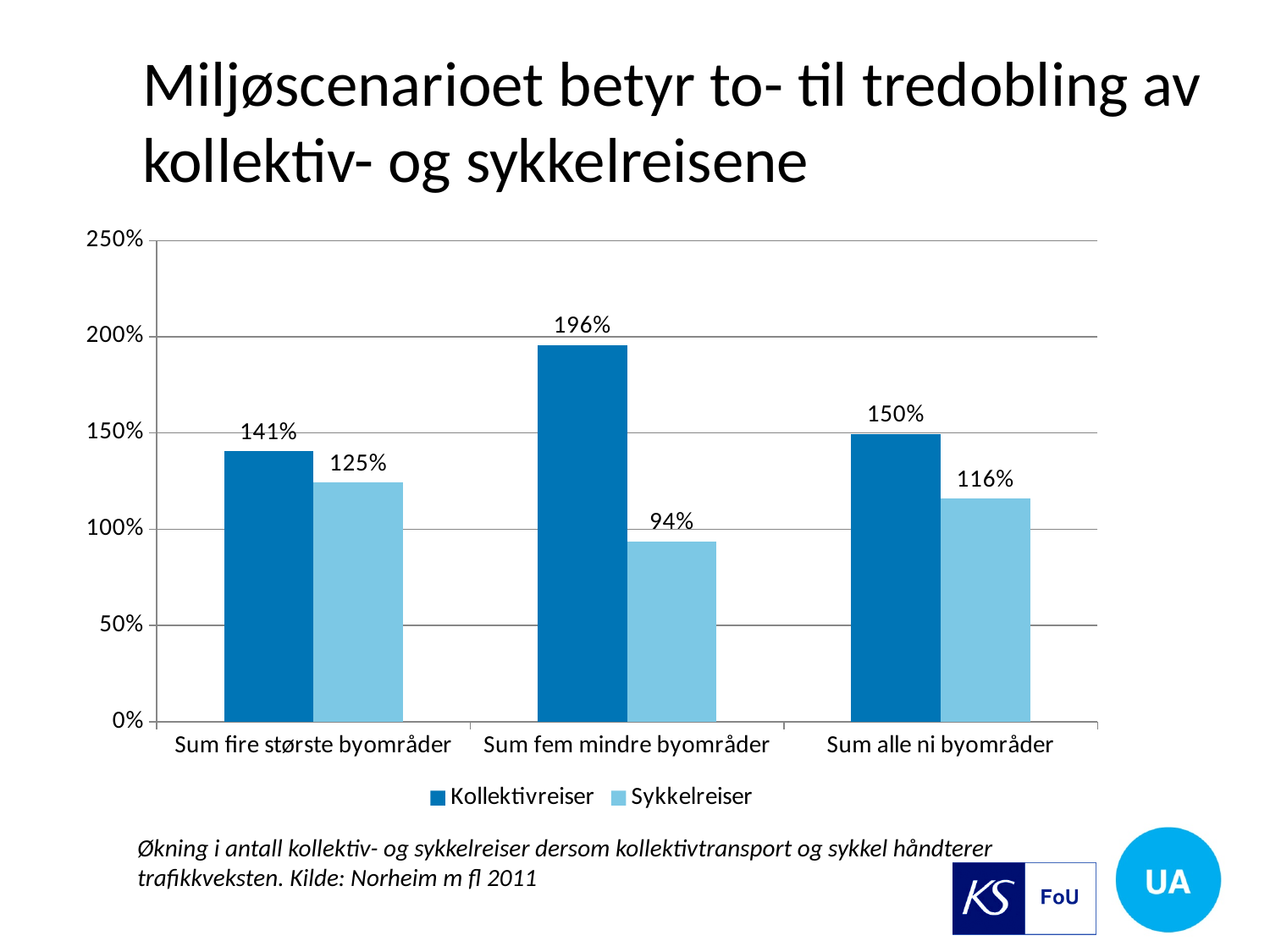
How many categories are shown on the x axis? 3 Which category has the highest value for Kollektivreiser? Sum fem mindre byområder What kind of chart is shown on the slide? Bar chart Which series is shown in the darker blue colour? Kollektivreiser Which category has the lowest value for Sykkelreiser? Sum fem mindre byområder How many series does the legend list? 2 What is the value for Sykkelreiser in Sum fem mindre byområder? 94% What is the difference between Kollektivreiser and Sykkelreiser in Sum alle ni byområder? 34% What is the value for Sykkelreiser in Sum alle ni byområder? 116% What is the value for Kollektivreiser in Sum fire største byområder? 141% Which is larger in Sum fire største byområder: Kollektivreiser or Sykkelreiser? Kollektivreiser What is the difference between Kollektivreiser and Sykkelreiser in Sum fem mindre byområder? 102%